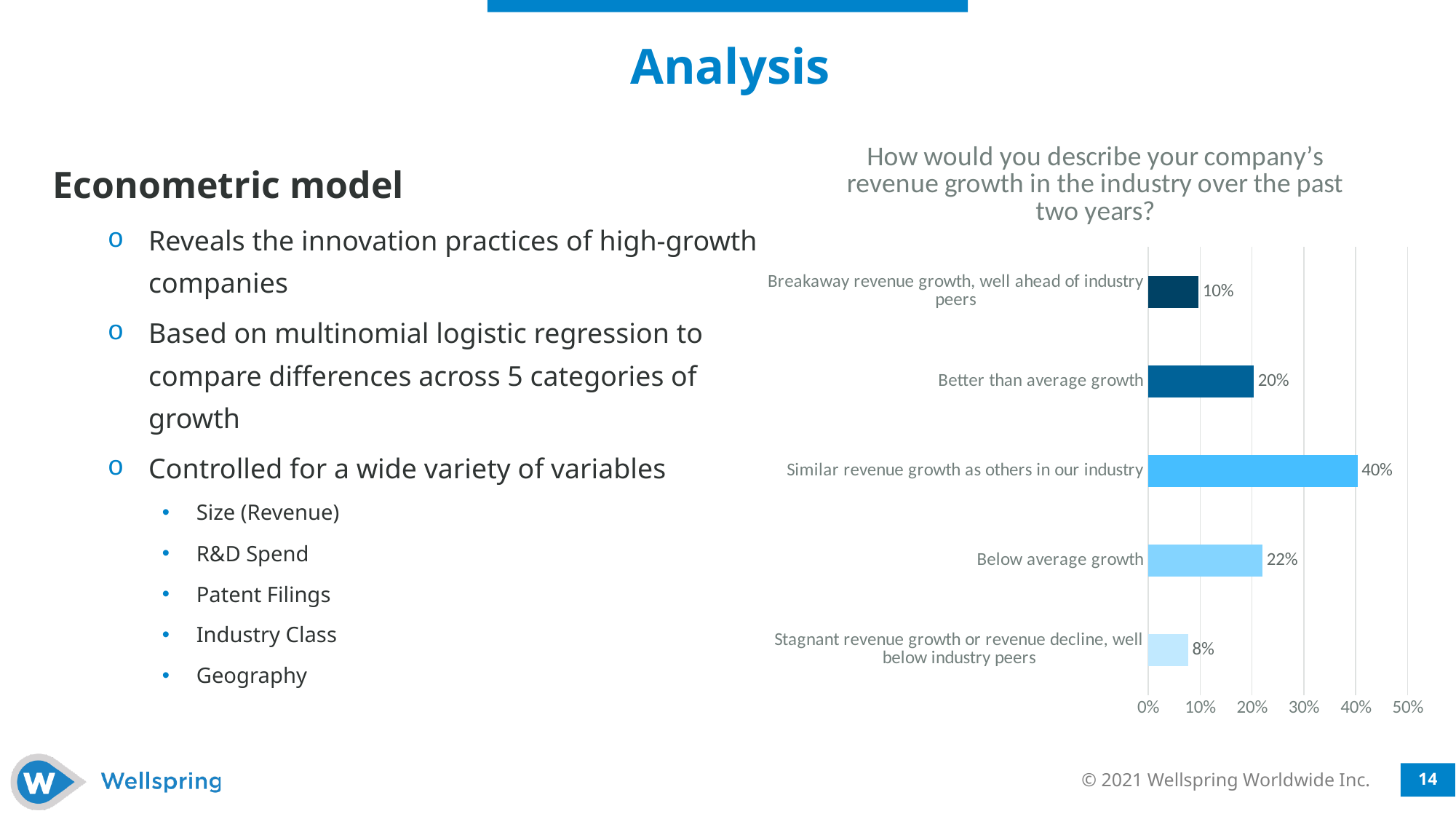
Which category has the highest value in the chart? Similar revenue growth as others in our industry How many categories are shown in the chart? 5 Which is larger: 'Below average growth' or 'Breakaway revenue growth, well ahead of industry peers'? Below average growth What percentage of respondents described their company's revenue growth as 'Similar revenue growth as others in our industry'? 40% What percentage is shown for 'Stagnant revenue growth or revenue decline, well below industry peers'? 8% What is the difference between 'Below average growth' and 'Better than average growth'? 2% What type of chart is shown on the slide? Bar chart What value is shown for 'Better than average growth'? 20% What is the maximum value shown on the chart's horizontal axis? 50% What is the title of the chart? How would you describe your company's revenue growth in the industry over the past two years? What is the difference between 'Similar revenue growth as others in our industry' and 'Breakaway revenue growth, well ahead of industry peers'? 30% Which category has the lowest value in the chart? Stagnant revenue growth or revenue decline, well below industry peers